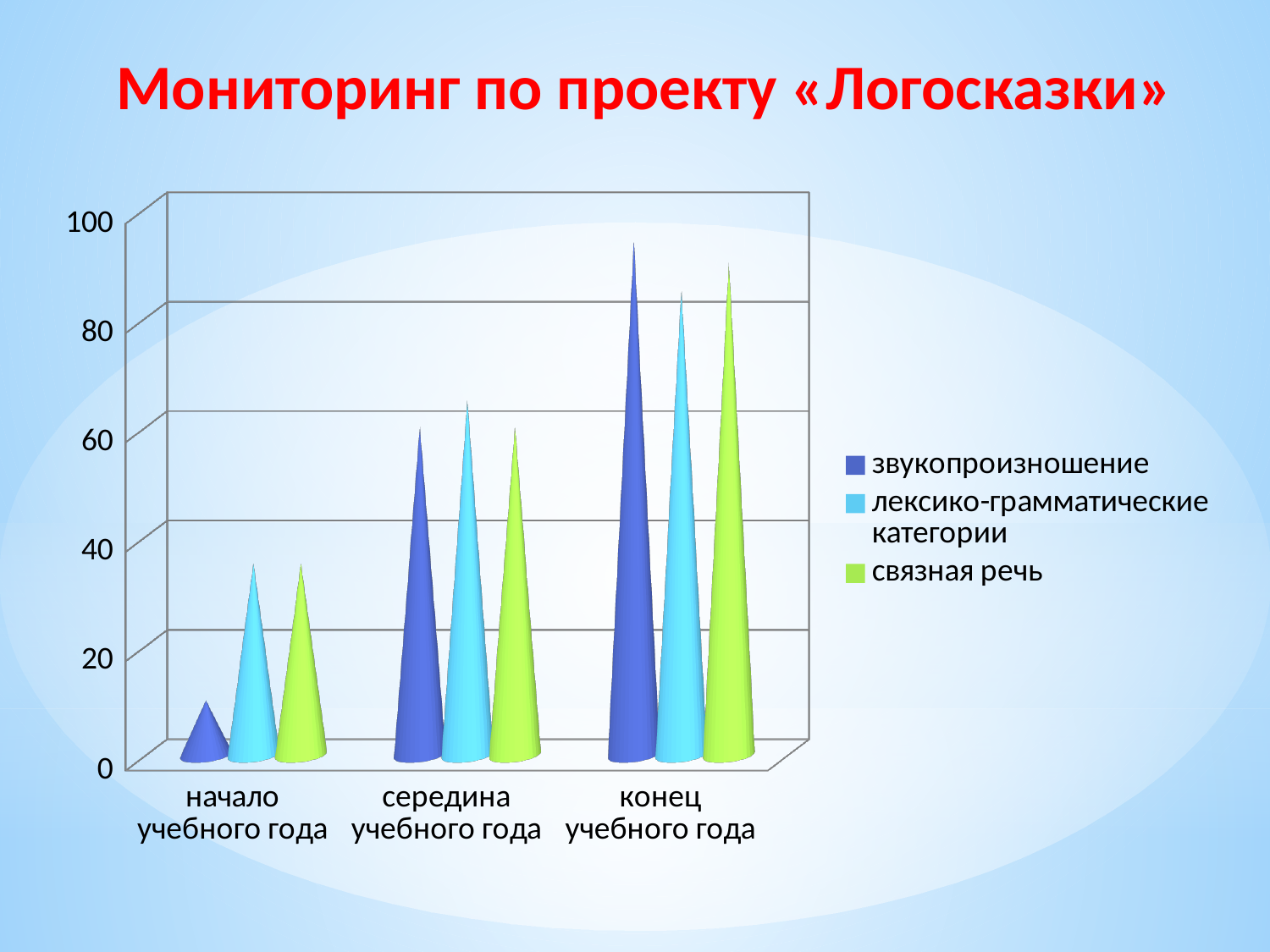
Do the values for звукопроизношение rise or fall from начало учебного года to конец учебного года? rise Is the value for связная речь at середина учебного года greater or less than 40? greater What kind of chart is shown on the slide? bar chart Which series is shown in green in the legend? связная речь How many series does the legend list? 3 Is the value for лексико-грамматические категории at конец учебного года greater or less than 80? greater In which category is the value for связная речь lowest? начало учебного года How many categories are shown on the x axis of the chart? 3 In which category is the value for звукопроизношение highest? конец учебного года At начало учебного года, which is larger: звукопроизношение or лексико-грамматические категории? лексико-грамматические категории Is the value for звукопроизношение at начало учебного года greater or less than 20? less What is the title of the slide with the chart? Мониторинг по проекту «Логосказки»